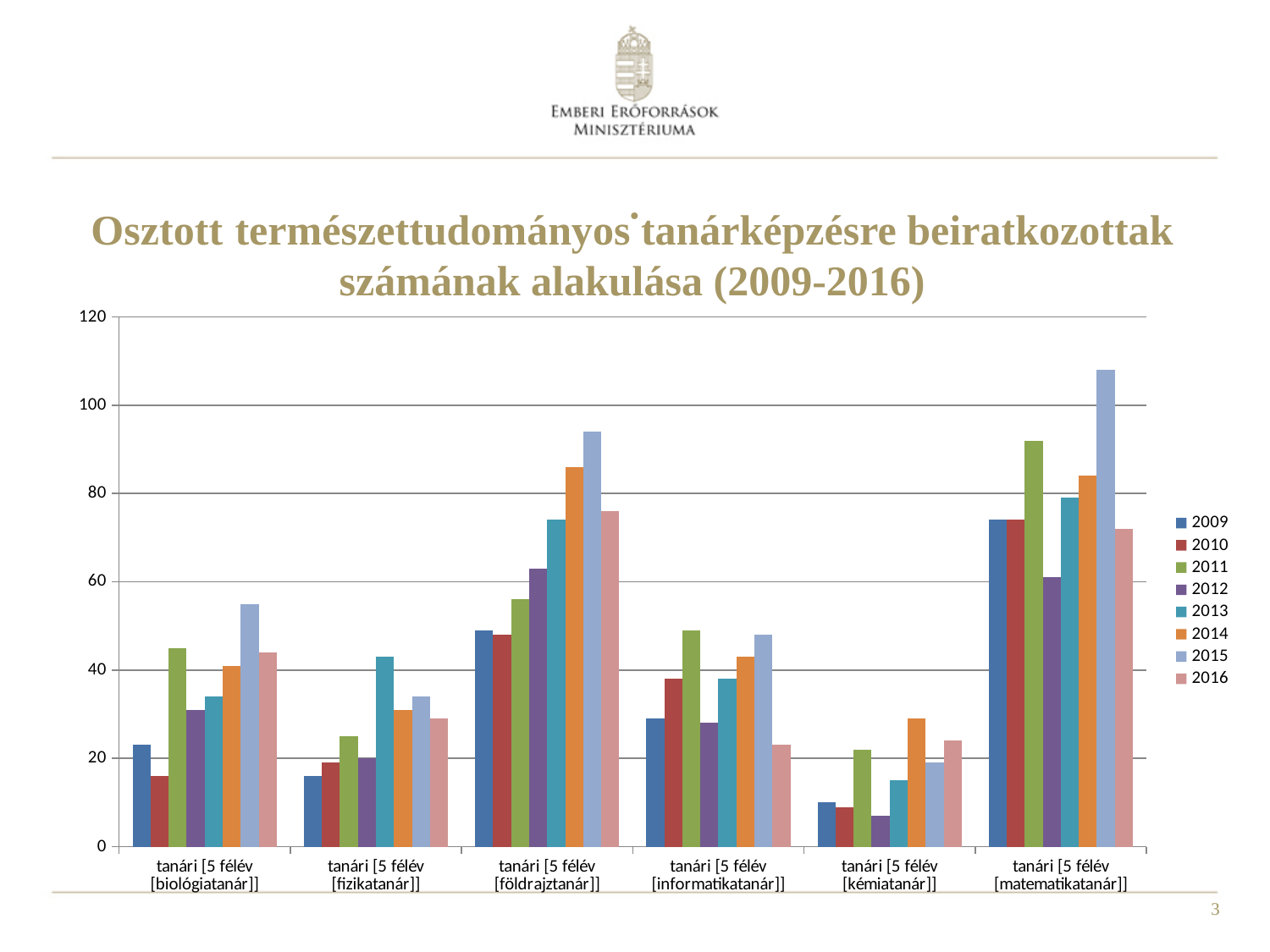
Is the 2015 value for tanári [5 félév [matematikatanár]] greater or less than 100? greater Is the 2014 value for tanári [5 félév [földrajztanár]] greater or less than 80? greater Is the 2012 value for tanári [5 félév [kémiatanár]] greater or less than 20? less Within the tanári [5 félév [kémiatanár]] category, which year has the highest value? 2014 Which category has the lowest value for the 2015 series? tanári [5 félév [kémiatanár]] Within the tanári [5 félév [matematikatanár]] category, which year has the lowest value? 2012 What is the first entry listed in the legend? 2009 How many series does the legend list? 8 How many teacher-training categories are shown along the x axis? 6 Which category has the highest value for the 2015 series? tanári [5 félév [matematikatanár]] What kind of chart is shown on the slide? bar chart For the 2011 series, which is larger: tanári [5 félév [biológiatanár]] or tanári [5 félév [fizikatanár]]? tanári [5 félév [biológiatanár]]